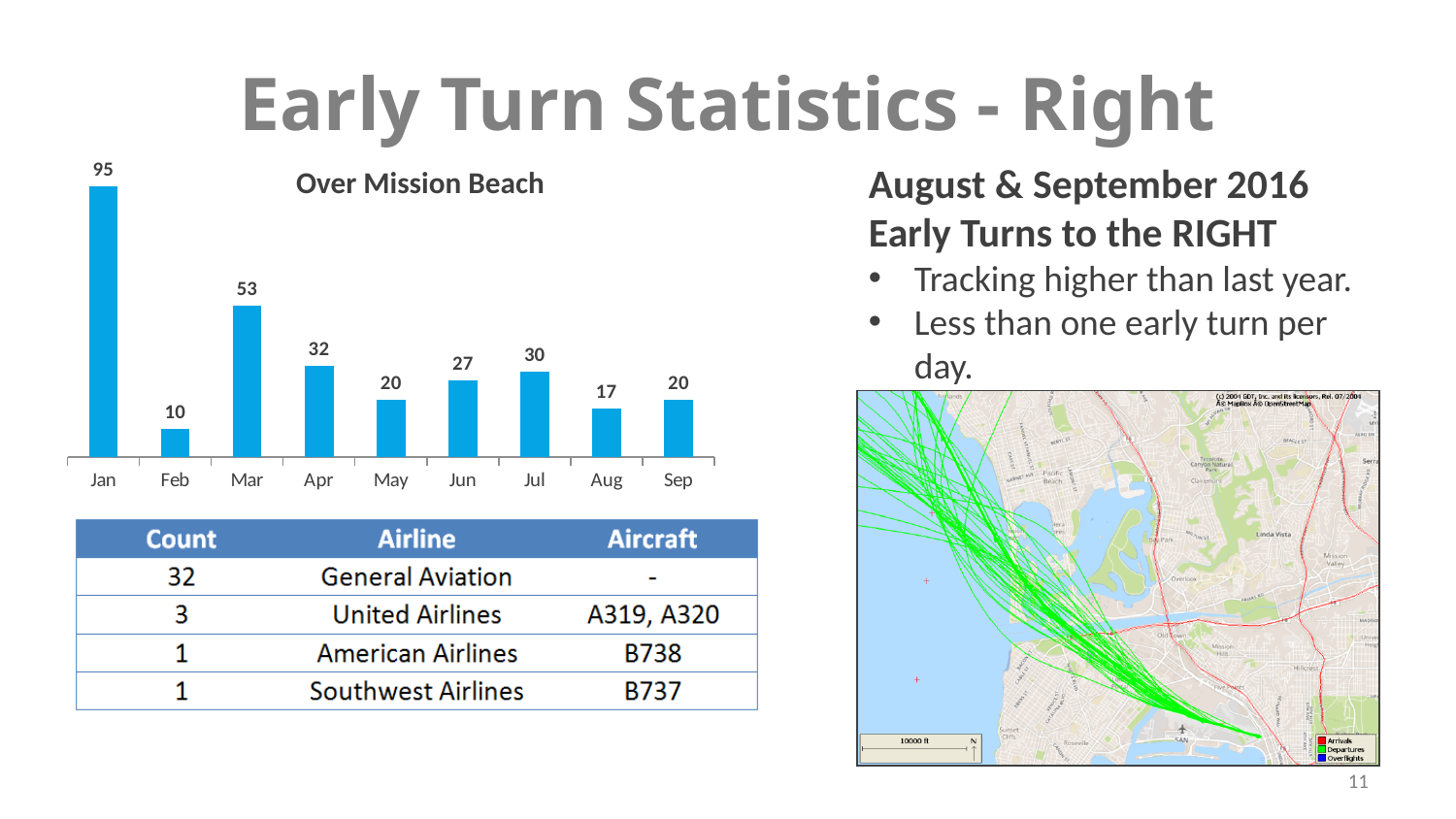
What is the value for Jan in the 'Over Mission Beach' chart? 95 What is the difference between the values for Mar and Apr in the 'Over Mission Beach' chart? 21 What is the value for Mar in the 'Over Mission Beach' chart? 53 What kind of chart is the 'Over Mission Beach' chart? bar chart What is the value for Aug in the 'Over Mission Beach' chart? 17 Which month has the lowest value in the 'Over Mission Beach' chart? Feb In the 'Over Mission Beach' chart, do the values rise or fall from Jan to Feb? fall What is the title of the bar chart on the slide? Over Mission Beach What is the difference between the values for Jan and Feb in the 'Over Mission Beach' chart? 85 In the 'Over Mission Beach' chart, which is larger, the value for Jun or the value for Jul? Jul Which month has the highest value in the 'Over Mission Beach' chart? Jan How many months are shown in the 'Over Mission Beach' chart? 9